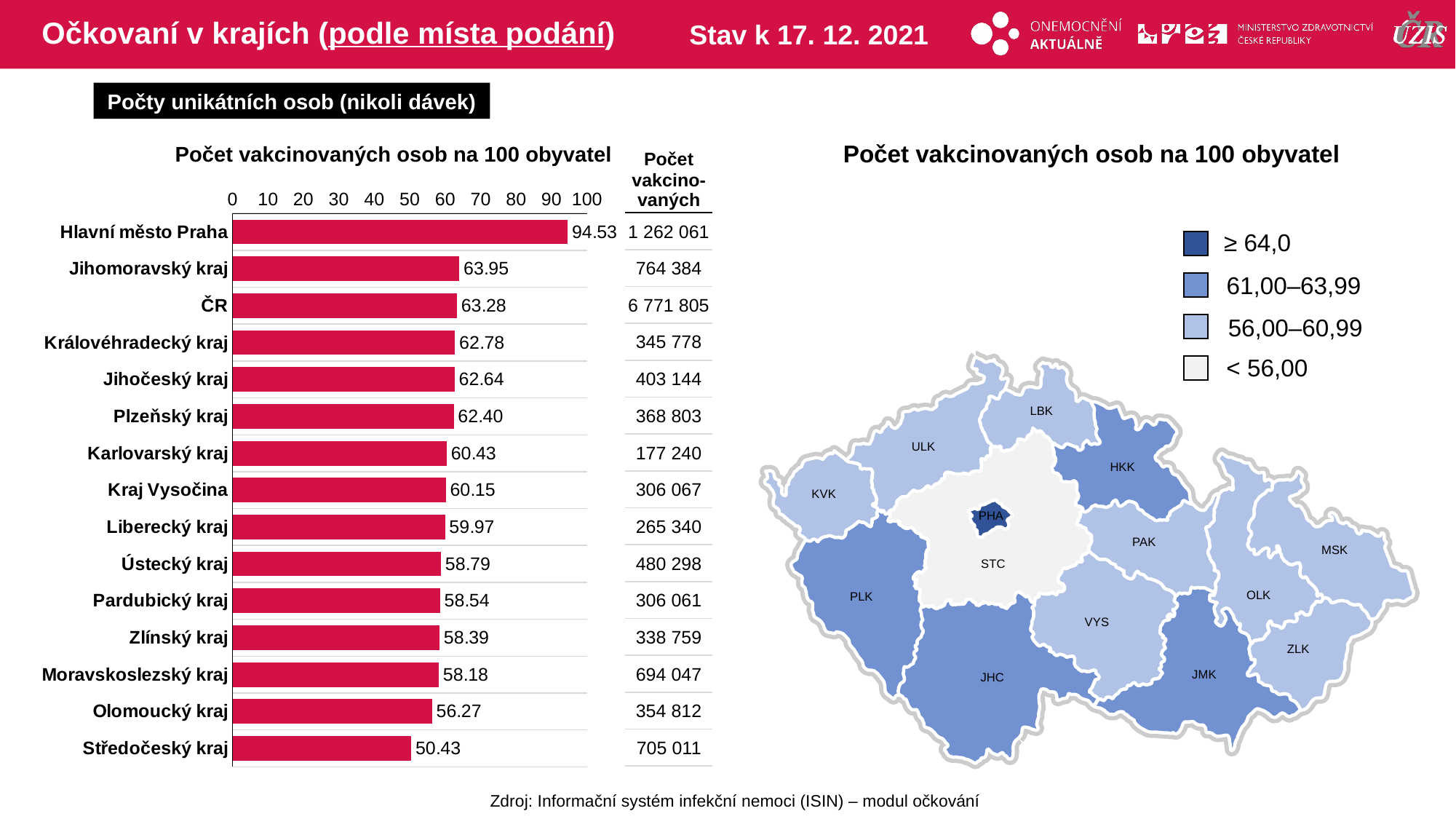
In the bar chart, what is the value for Olomoucký kraj? 56.27 What is the title of the bar chart on the left of the slide? Počet vakcinovaných osob na 100 obyvatel In the bar chart, is the value for Hlavní město Praha greater or less than 90? greater Which region has the highest number of vaccinated persons per 100 inhabitants in the bar chart? Hlavní město Praha In the bar chart, what is the value for Hlavní město Praha? 94.53 In the bar chart, what is the difference between the values for Hlavní město Praha and Středočeský kraj? 44.10 In the bar chart, what is the value for Jihočeský kraj? 62.64 In the bar chart, which has a larger value: Jihomoravský kraj or Olomoucký kraj? Jihomoravský kraj What type of chart is used to show the number of vaccinated persons per 100 inhabitants by region? bar chart Which region has the lowest number of vaccinated persons per 100 inhabitants in the bar chart? Středočeský kraj How many bars (regions including ČR) are shown in the bar chart? 15 In the bar chart, what is the value for ČR? 63.28